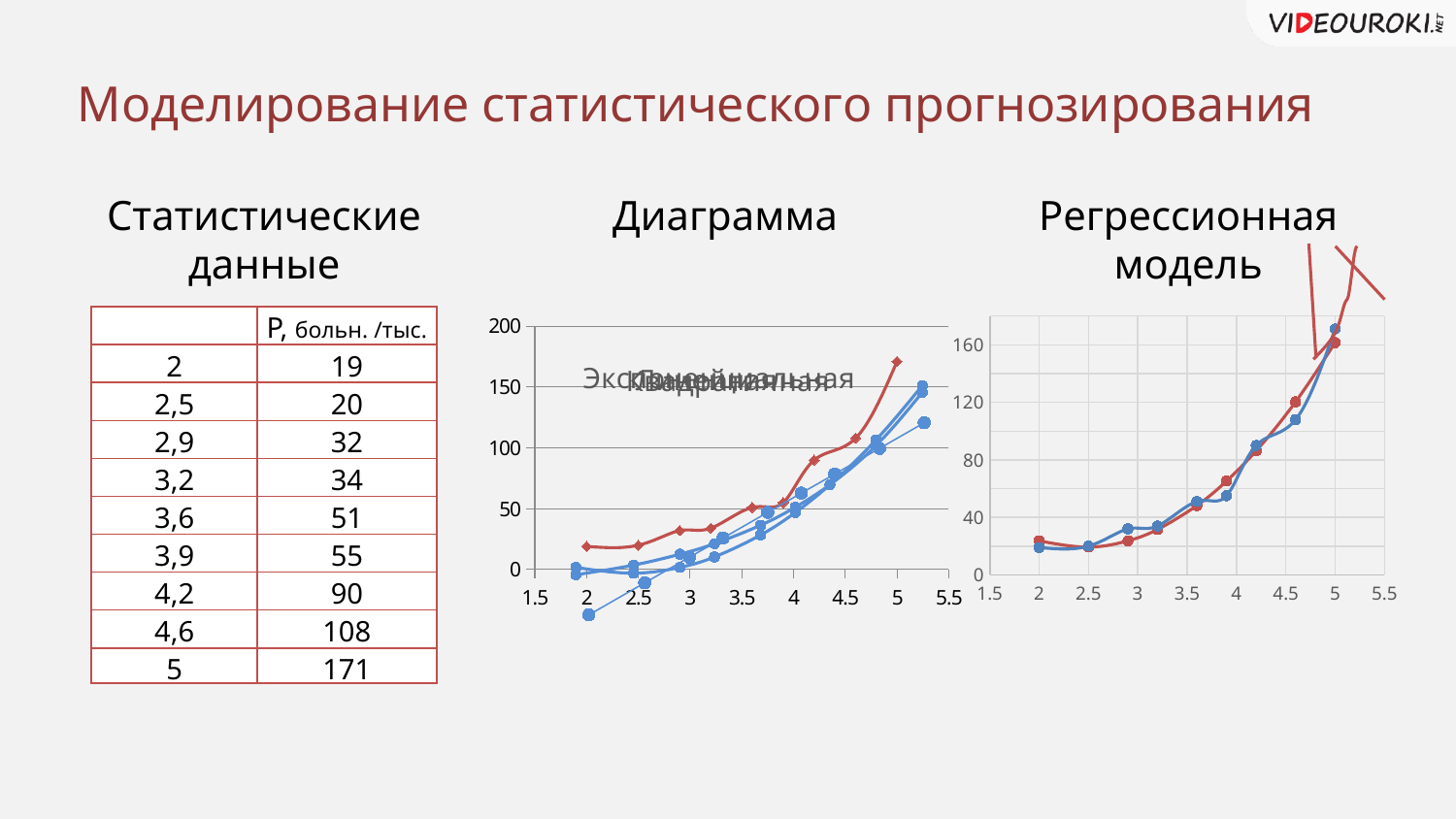
In the right chart "Регрессионная модель", which is larger: the value at x = 4.6 or the value at x = 3.6? x = 4.6 In the right chart "Регрессионная модель", is the value at x = 5 greater or less than 120? greater In the right chart "Регрессионная модель", is the value at x = 2 greater or less than 40? less In the middle chart "Диаграмма", which is larger at x = 5: the red series or the blue series? red series What kind of chart is the middle chart titled "Диаграмма"? line chart What kind of chart is the right chart titled "Регрессионная модель"? line chart In the right chart "Регрессионная модель", do the values rise or fall as x increases from 2 to 5? rise What is the highest tick value on the vertical axis of the right chart "Регрессионная модель"? 160 In the middle chart "Диаграмма", is the value of the red series at x = 3.5 greater or less than 100? less What is the highest tick value on the vertical axis of the middle chart "Диаграмма"? 200